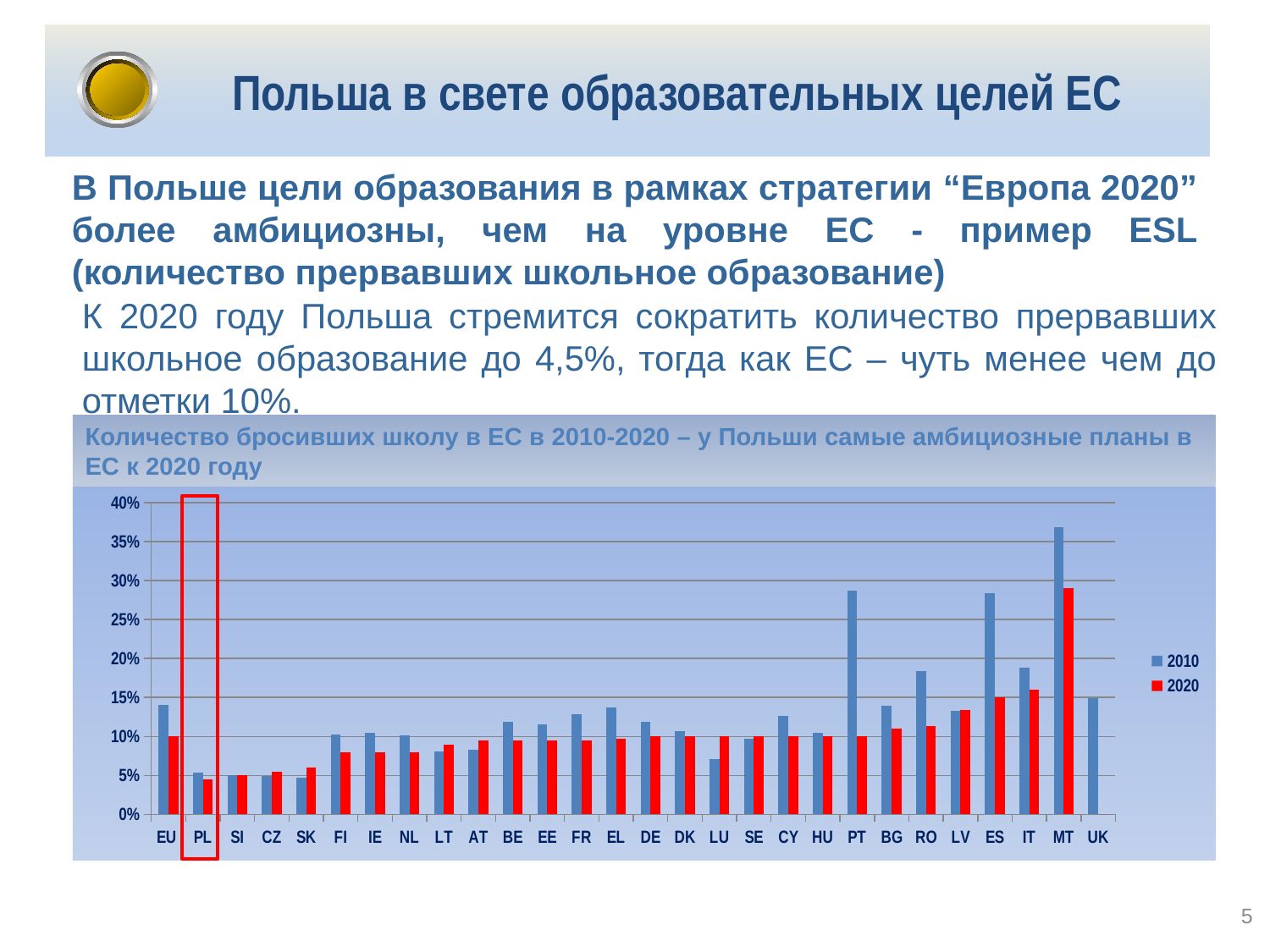
How many countries/categories are shown on the x axis of the chart? 28 How many series does the chart legend list? 2 Is the 2010 value for LU greater or less than 10%? less Which series are listed in the chart legend? 2010 and 2020 Which is larger for MT: the 2010 value or the 2020 value? 2010 Which category has the highest 2010 value in the chart? MT Is the 2010 value for MT greater or less than 35%? greater Which category has the highest 2020 value in the chart? MT Which category on the x axis is highlighted with a red box? PL What kind of chart is shown on the slide? bar chart Is the 2010 value for EU greater or less than 10%? greater